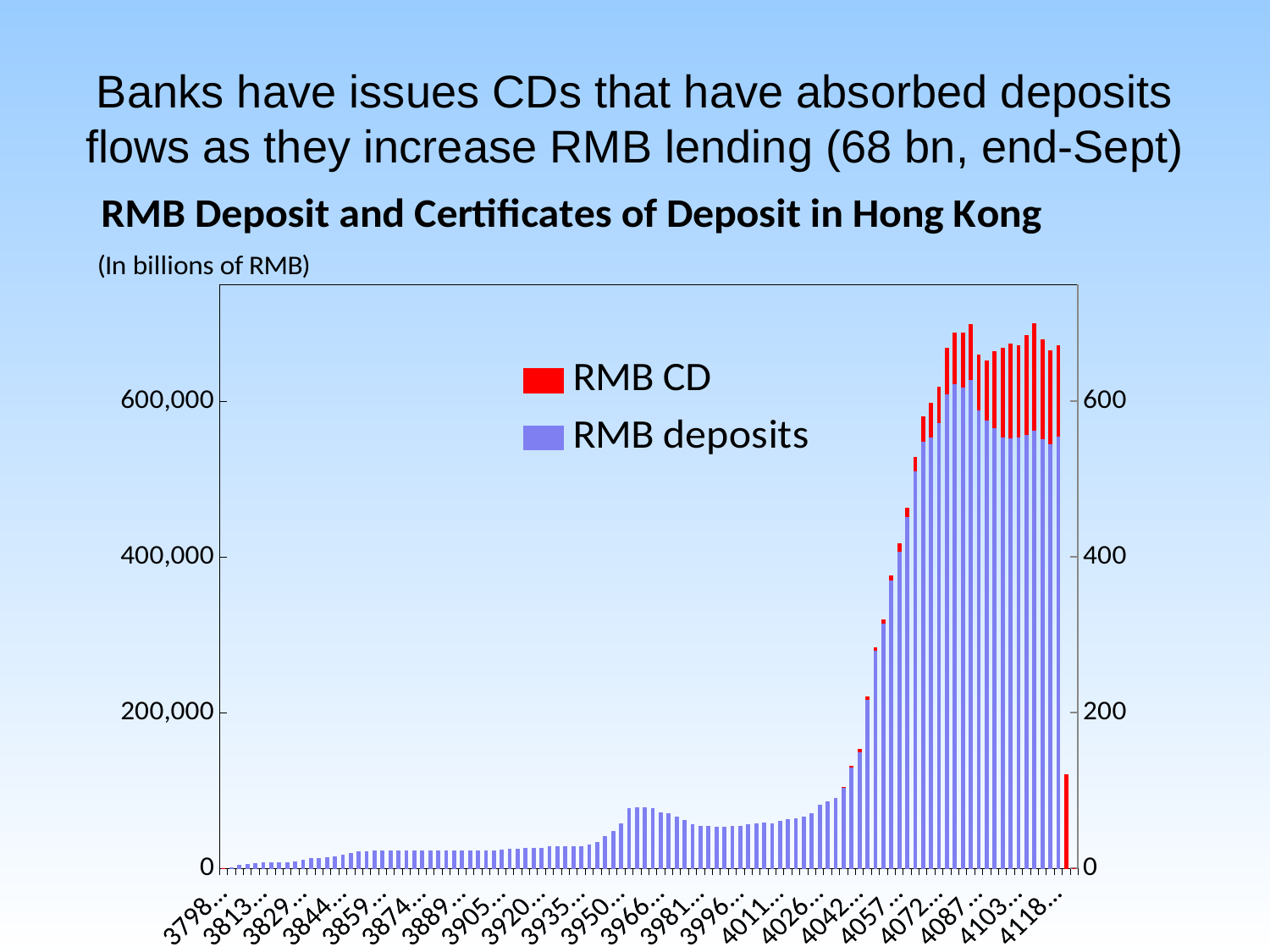
Is the RMB deposits value in the tallest bars greater or less than 400,000? greater What are the two series named in the chart legend? RMB CD and RMB deposits Do the values in the chart generally rise or fall from left to right along the x axis? Rise Which series is shown in red in the chart? RMB CD In the tallest bars on the right side of the chart, which series makes up the larger part: RMB CD or RMB deposits? RMB deposits Are the values of the bars at the far left of the chart greater or less than 200,000? less What is the highest tick value shown on the right-hand axis of the chart? 600 Is the total of the tallest stacked bar greater or less than 600,000 on the left axis? greater How many series does the chart legend list? 2 Which series is shown in blue in the chart? RMB deposits What kind of chart is shown on the slide? Stacked bar chart What is the title of the chart? RMB Deposit and Certificates of Deposit in Hong Kong